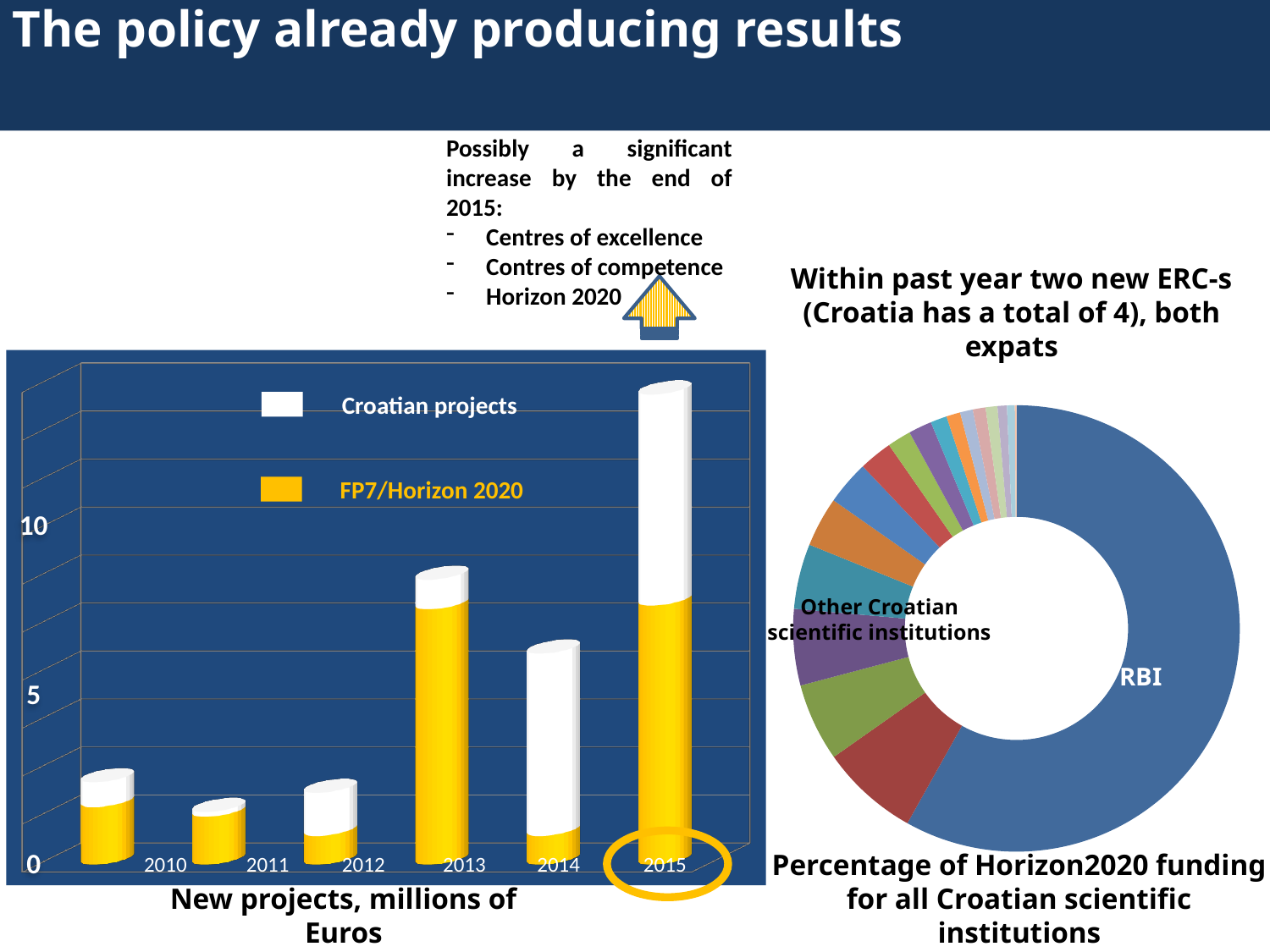
In the 'New projects, millions of Euros' chart, which year has the shortest bar? 2011 In the 'New projects, millions of Euros' chart, is the total bar for 2015 greater or less than 10? greater What kind of chart is the 'New projects, millions of Euros' chart? bar chart In the 'New projects, millions of Euros' chart, which colour represents FP7/Horizon 2020 in the legend? yellow In the 'New projects, millions of Euros' chart, how many years are shown on the x axis? 6 In the 'New projects, millions of Euros' chart, is the total bar for 2010 greater or less than 5? less In the 'New projects, millions of Euros' chart, which year has the larger total bar, 2013 or 2014? 2013 In the 'Percentage of Horizon2020 funding for all Croatian scientific institutions' chart, which institution has the largest slice? RBI In the 'New projects, millions of Euros' chart, how many series does the legend list? 2 In the 'New projects, millions of Euros' chart, is the total bar for 2014 greater or less than 5? greater In the 'New projects, millions of Euros' chart, which year has the tallest bar? 2015